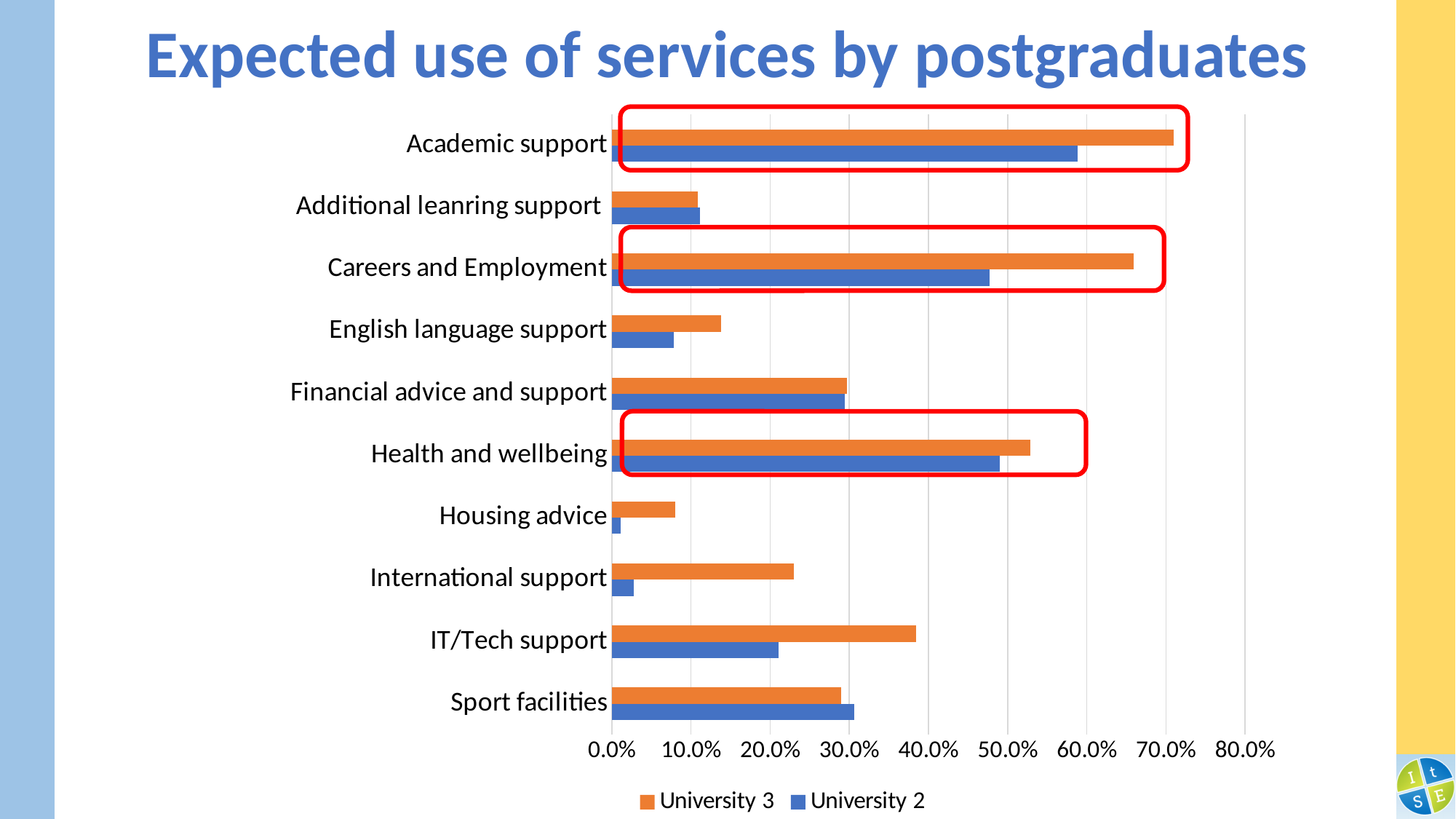
For Housing advice, which university has the larger value, University 3 or University 2? University 3 Is the University 3 value for Academic support greater or less than 60.0%? greater For Careers and Employment, which university has the larger value, University 3 or University 2? University 3 Which service has the highest value for University 2? Academic support What kind of chart is shown on the slide? bar chart Which service has the lowest value for University 2? Housing advice How many series does the legend list? 2 How many service categories are plotted on the chart? 10 What is the title of the chart? Expected use of services by postgraduates Is the University 3 value for IT/Tech support greater or less than 30.0%? greater Which service has the highest value for University 3? Academic support Is the University 2 value for International support greater or less than 10.0%? less